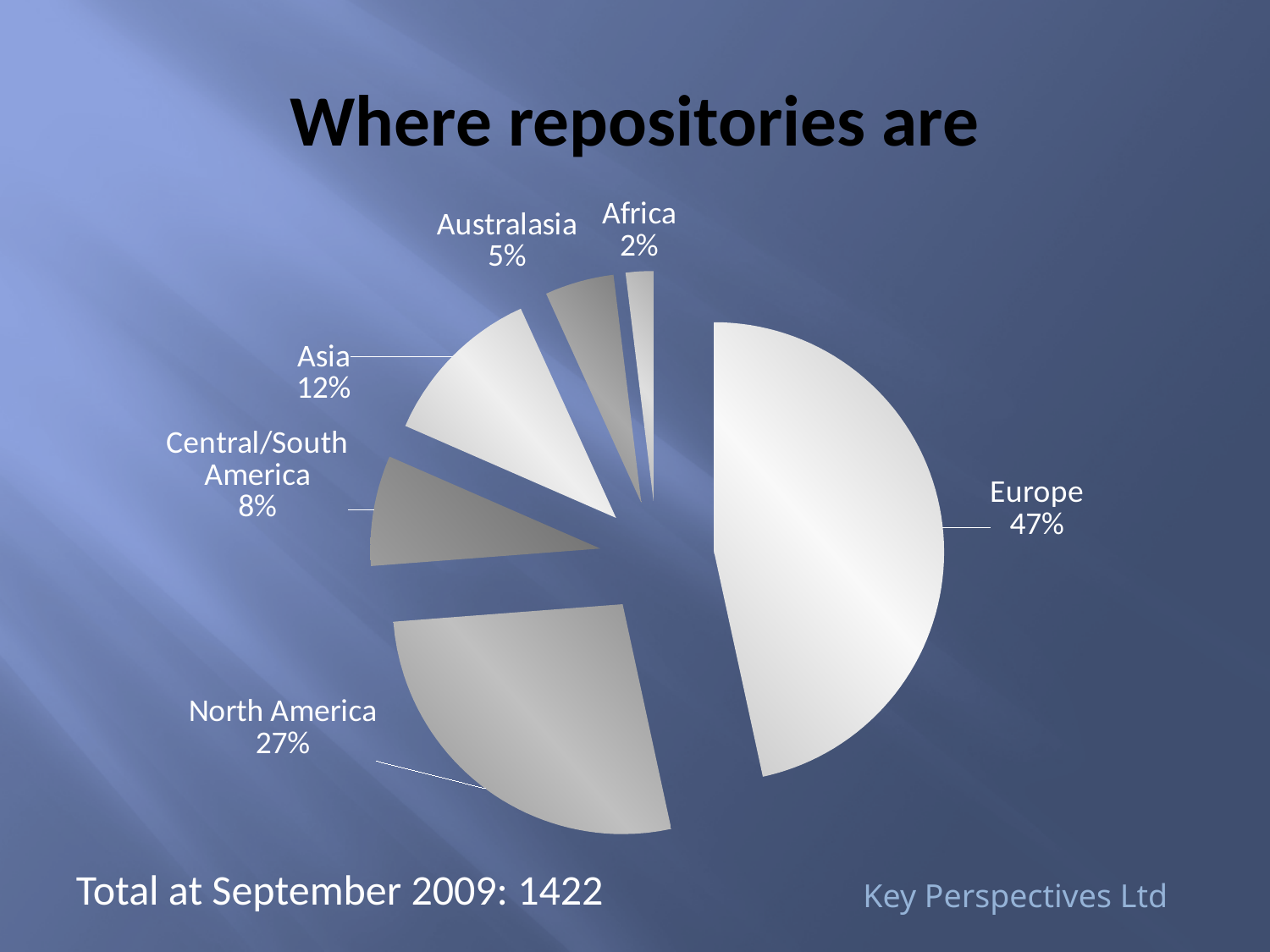
What share of repositories is in Europe? 47% What share of repositories is in Asia? 12% Which region has the largest share of repositories? Europe How many regions are shown in the pie chart? 6 Which has a larger share, Asia or Australasia? Asia Which region has the smallest share of repositories? Africa What type of chart is shown on the slide? pie chart What is the difference in percentage points between Europe and North America? 20 What share of repositories is in Africa? 2% What is the title of the chart? Where repositories are What share of repositories is in North America? 27% What share of repositories is in Central/South America? 8%